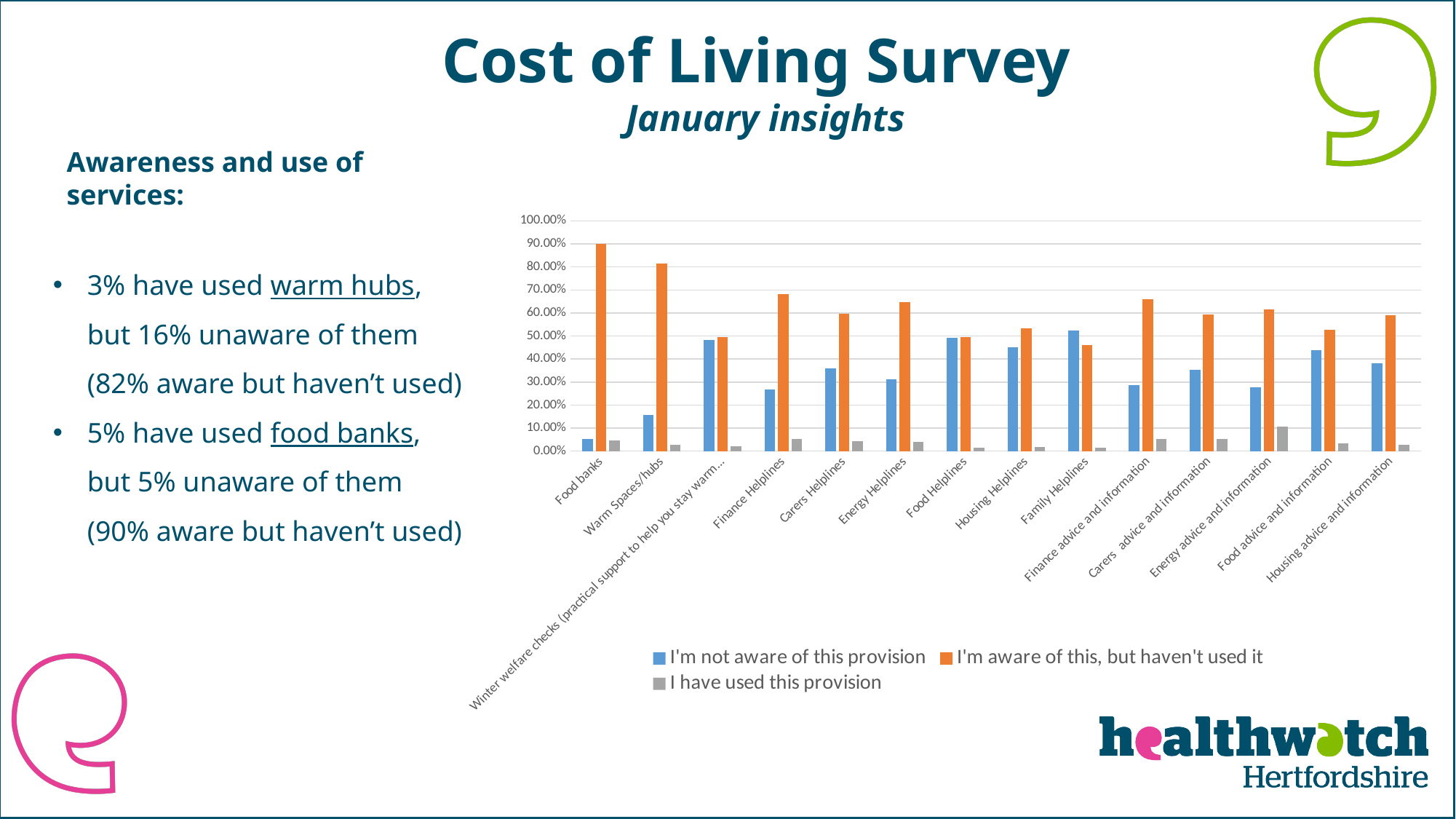
Which category has the highest value for "I have used this provision"? Energy advice and information Is the value for Carers Helplines in the "I'm not aware of this provision" series greater or less than 30.00%? greater Which category has the highest value for "I'm aware of this, but haven't used it"? Food banks What kind of chart is shown on the slide? Bar chart How many service categories are shown along the x axis of the chart? 14 Is the value for Food banks in the "I'm aware of this, but haven't used it" series greater or less than 80.00%? greater For Housing Helplines, which is larger: "I'm not aware of this provision" or "I'm aware of this, but haven't used it"? I'm aware of this, but haven't used it Which category has the lowest value for "I'm not aware of this provision"? Food banks Which colour represents "I have used this provision" in the chart's legend? Grey How many series does the chart's legend list? 3 Is the value for Warm Spaces/hubs in the "I'm not aware of this provision" series greater or less than 20.00%? less